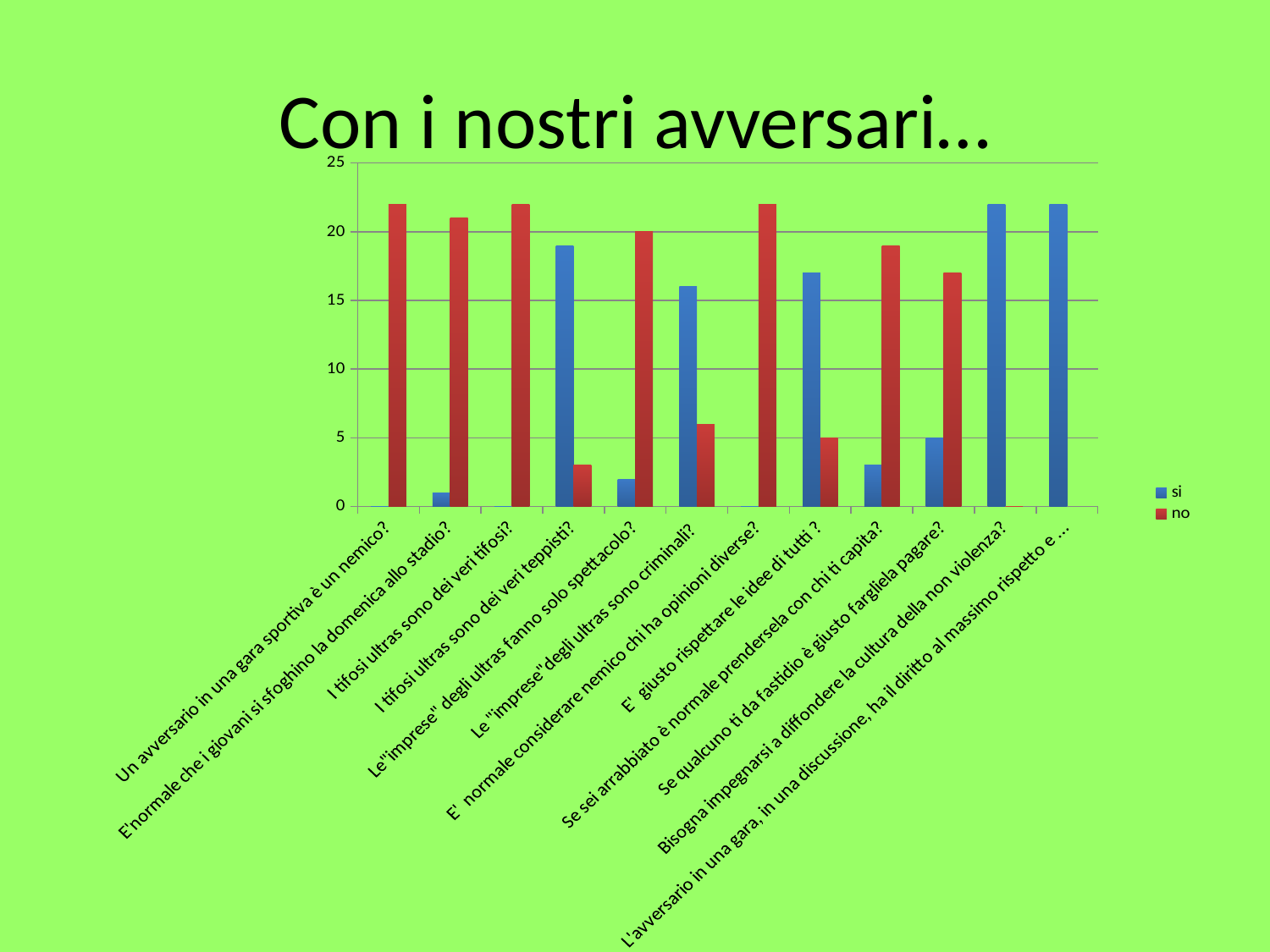
Is the 'no' value for 'I tifosi ultras sono dei veri teppisti?' greater or less than 5? less For 'E' normale considerare nemico chi ha opinioni diverse?', which is larger, the 'si' value or the 'no' value? no What is the title of the slide? Con i nostri avversari… Is the 'no' value for 'Se qualcuno ti da fastidio è giusto fargliela pagare?' greater or less than 15? greater What kind of chart is shown on the slide? bar chart What are the two series named in the legend? si and no How many question categories are shown on the x axis? 12 Is the 'no' value for 'Un avversario in una gara sportiva è un nemico?' greater or less than 20? greater How many series does the legend list? 2 For 'Bisogna impegnarsi a diffondere la cultura della non violenza?', which is larger, the 'si' value or the 'no' value? si